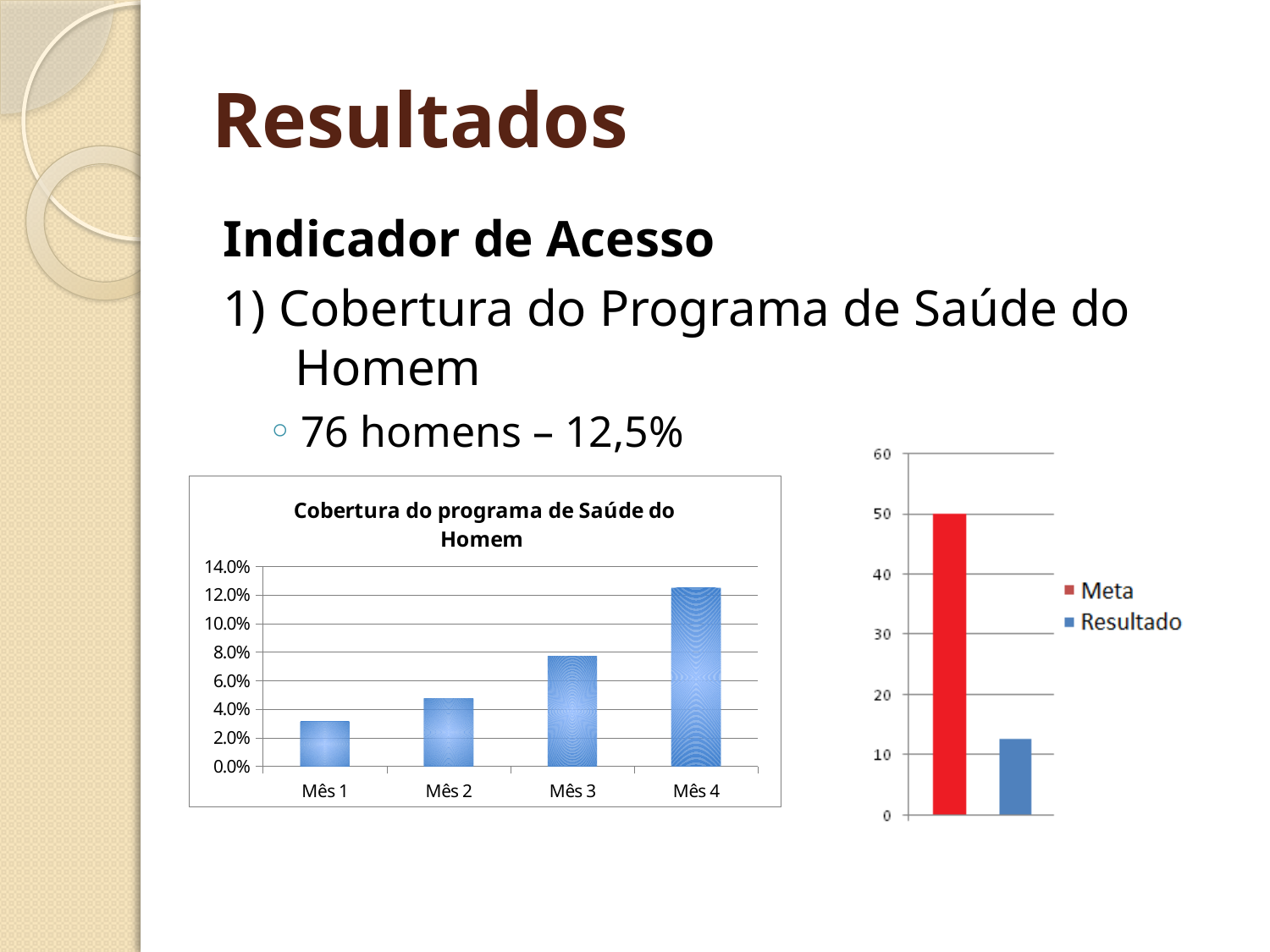
On the chart titled 'Cobertura do programa de Saúde do Homem', which month has the highest value? Mês 4 What kind of chart is the one titled 'Cobertura do programa de Saúde do Homem'? bar chart On the chart on the right of the slide, what is the value of Meta? 50 On the chart titled 'Cobertura do programa de Saúde do Homem', is the value for Mês 4 greater or less than 10.0%? greater On the chart titled 'Cobertura do programa de Saúde do Homem', is the value for Mês 1 greater or less than 4.0%? less On the chart titled 'Cobertura do programa de Saúde do Homem', is the value for Mês 3 greater or less than 6.0%? greater On the chart titled 'Cobertura do programa de Saúde do Homem', do the values rise or fall from Mês 1 to Mês 4? rise On the chart titled 'Cobertura do programa de Saúde do Homem', how many months are shown on the x axis? 4 On the chart on the right of the slide, which is larger, Meta or Resultado? Meta On the chart titled 'Cobertura do programa de Saúde do Homem', which month has the lowest value? Mês 1 On the chart on the right of the slide, how many series does the legend list? 2